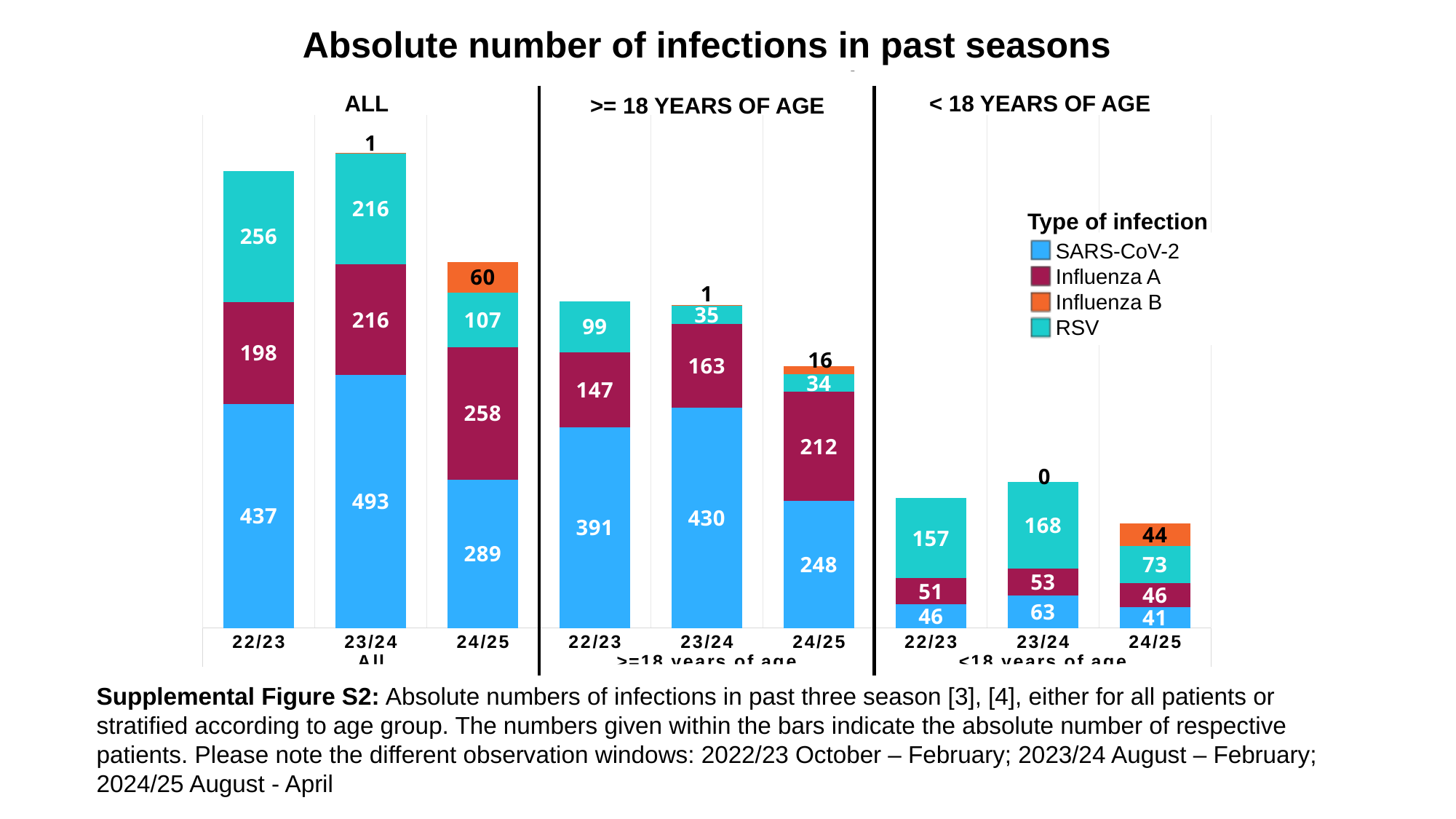
In the < 18 YEARS OF AGE panel, what is the total number of infections in the 24/25 season (sum of all four types)? 204 How many types of infection does the legend list? 4 In the < 18 YEARS OF AGE panel, which season has the lowest number of SARS-CoV-2 infections? 24/25 In the >= 18 YEARS OF AGE panel, what is the number of Influenza A infections in the 24/25 season? 212 What kind of chart is shown on the slide? Stacked bar chart In the >= 18 YEARS OF AGE panel, which is larger: RSV infections in 22/23 or in 23/24? 22/23 In the ALL panel, what is the difference between SARS-CoV-2 infections in 22/23 and 24/25? 148 In the < 18 YEARS OF AGE panel, what is the number of RSV infections in the 23/24 season? 168 In the ALL panel, what is the number of Influenza B infections in the 24/25 season? 60 In the ALL panel, which season has the highest number of SARS-CoV-2 infections? 23/24 In the ALL panel, what is the total number of infections in the 24/25 season (sum of all four types)? 714 In the ALL panel, what is the number of SARS-CoV-2 infections in the 23/24 season? 493